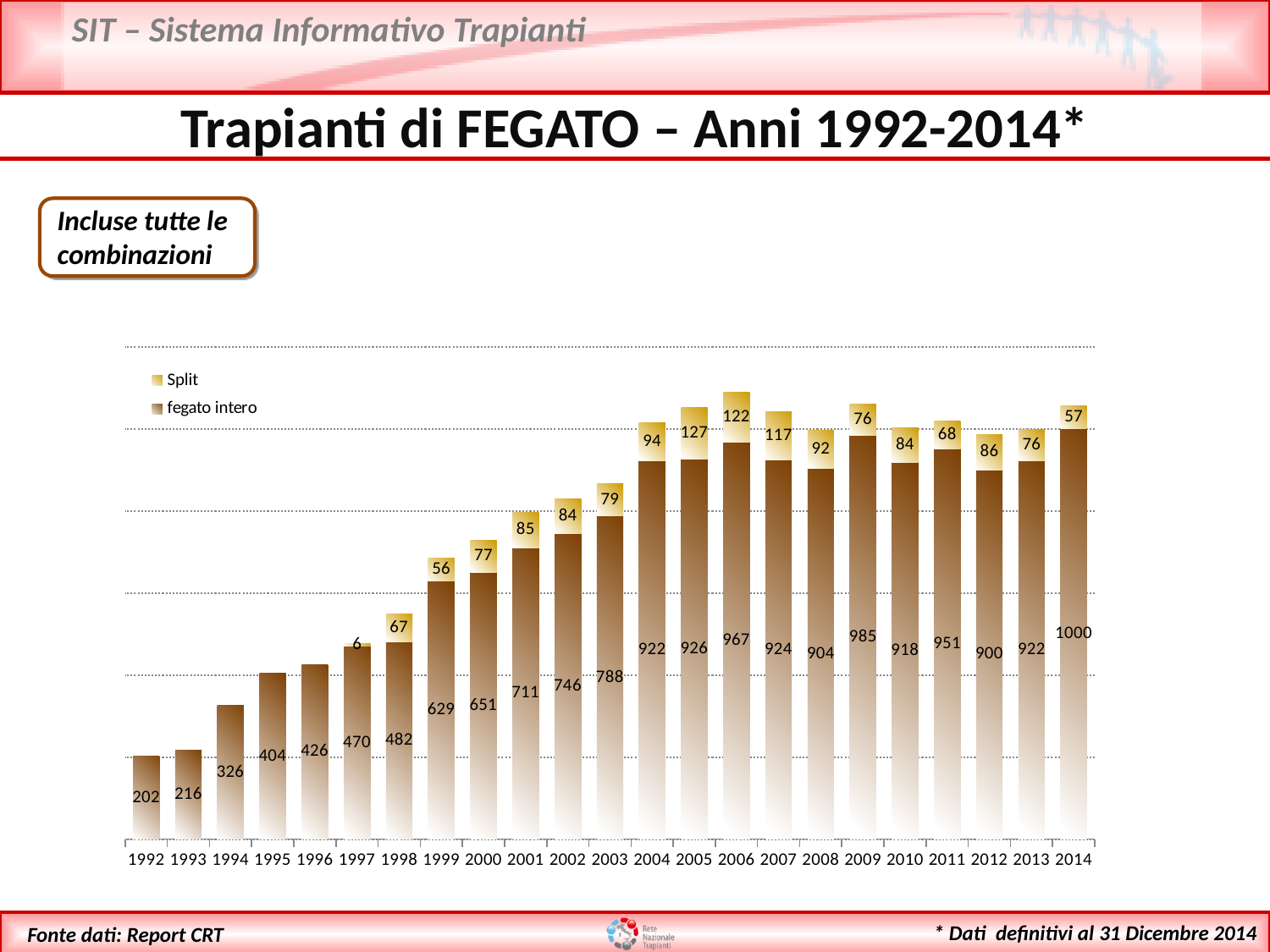
What is the difference between the 'fegato intero' values for 2014 and 2013? 78 What is the 'fegato intero' value for 1992? 202 What are the two series named in the legend? Split and fegato intero Which year has the lowest 'fegato intero' value? 1992 What is the value of 'fegato intero' for 2014? 1000 Which is larger, the 'fegato intero' value for 2006 or for 2009? 2009 Which year has the highest 'Split' value? 2005 How many series does the legend list? 2 What is the total of the stacked bar for 2014? 1057 What is the 'Split' value for 2005? 127 What kind of chart is shown on the slide? Stacked bar chart How many years are shown on the x axis? 23